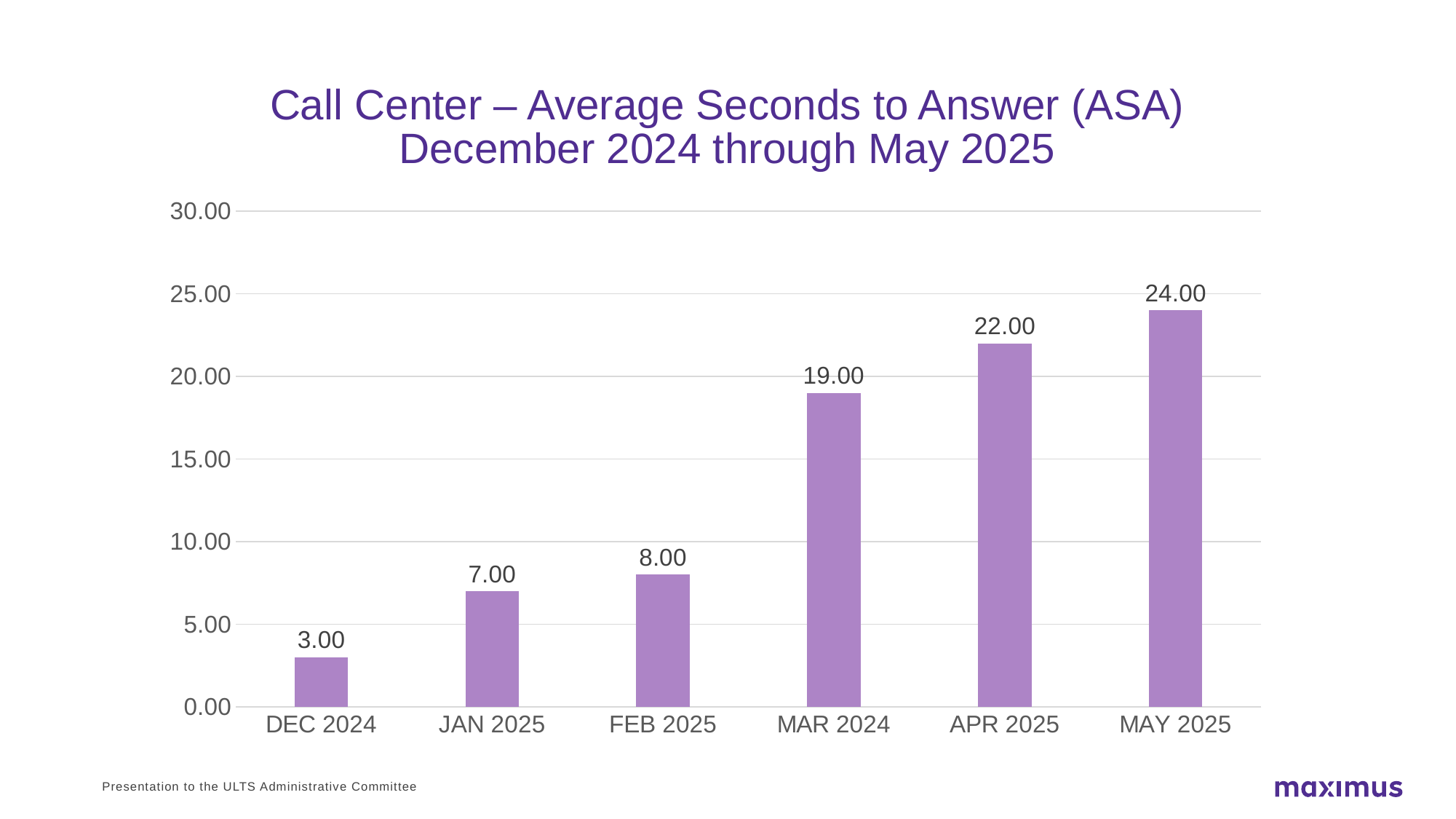
How many months are shown on the chart? 6 Is the value for APR 2025 greater or less than 20.00? greater What is the value shown for MAR 2024? 19.00 Do the values rise or fall from DEC 2024 to MAY 2025? Rise Which month has the lowest average seconds to answer? DEC 2024 What is the average seconds to answer for DEC 2024? 3.00 Which month has the highest average seconds to answer? MAY 2025 What kind of chart is shown on the slide? Bar chart What is the value shown for APR 2025? 22.00 Which is larger, the value for MAR 2024 or the value for FEB 2025? MAR 2024 What is the difference between the values for MAY 2025 and DEC 2024? 21.00 What is the difference between the values for FEB 2025 and JAN 2025? 1.00